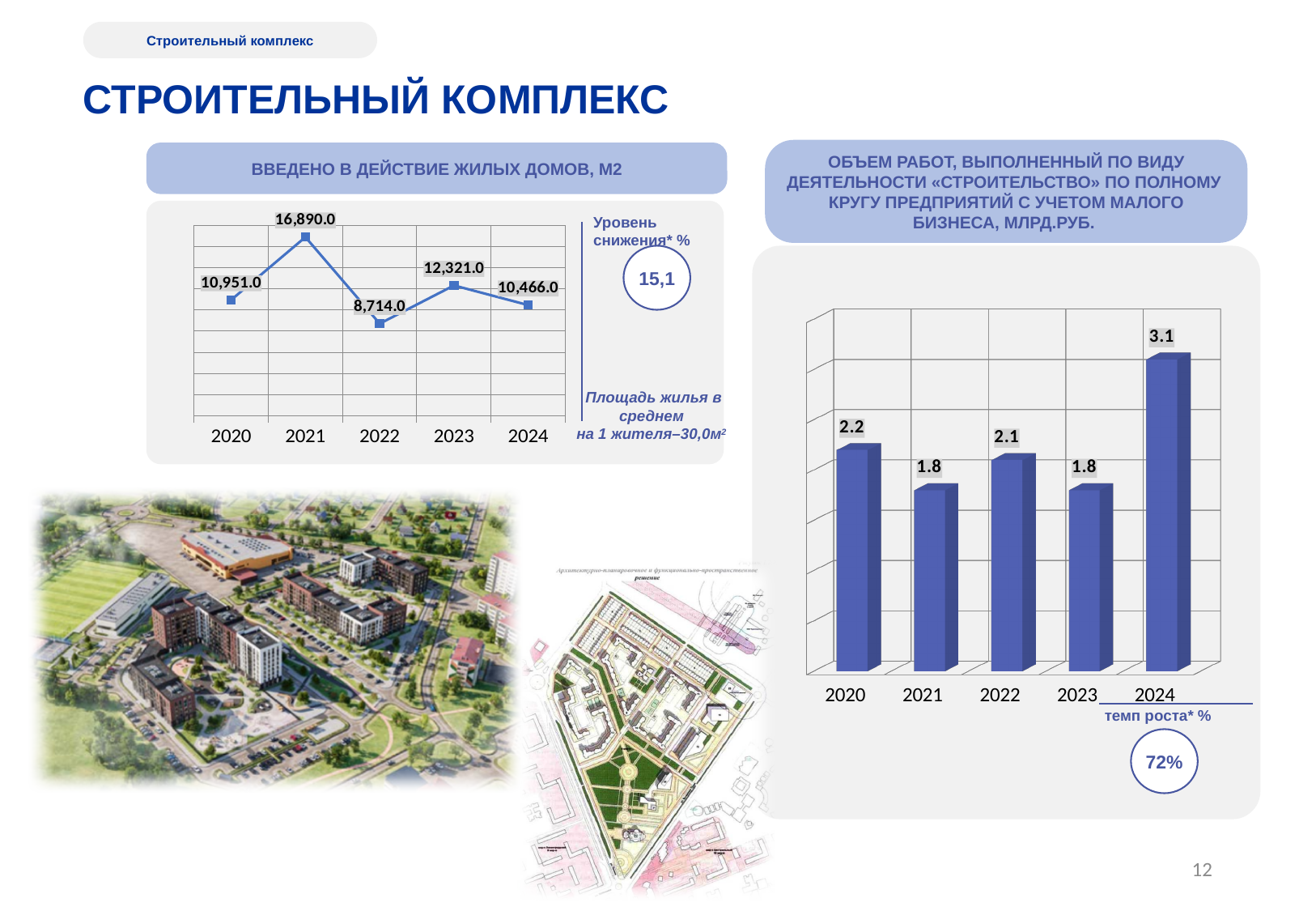
In the left chart (ВВЕДЕНО В ДЕЙСТВИЕ ЖИЛЫХ ДОМОВ, М2), which year has the lowest value? 2022 In the right chart (ОБЪЕМ РАБОТ, МЛРД.РУБ.), which year has the highest value? 2024 In the right chart (ОБЪЕМ РАБОТ, МЛРД.РУБ.), what is the difference between the 2024 and 2023 values? 1.3 In the left chart (ВВЕДЕНО В ДЕЙСТВИЕ ЖИЛЫХ ДОМОВ, М2), which year has the highest value? 2021 In the left chart (ВВЕДЕНО В ДЕЙСТВИЕ ЖИЛЫХ ДОМОВ, М2), what is the value for 2024? 10,466.0 In the left chart (ВВЕДЕНО В ДЕЙСТВИЕ ЖИЛЫХ ДОМОВ, М2), what is the difference between the 2021 and 2022 values? 8,176.0 In the left chart (ВВЕДЕНО В ДЕЙСТВИЕ ЖИЛЫХ ДОМОВ, М2), how many years are plotted? 5 What type of chart is the right chart (ОБЪЕМ РАБОТ, МЛРД.РУБ.)? Bar chart In the left chart (ВВЕДЕНО В ДЕЙСТВИЕ ЖИЛЫХ ДОМОВ, М2), what is the value for 2021? 16,890.0 In the right chart (ОБЪЕМ РАБОТ, МЛРД.РУБ.), what is the value for 2020? 2.2 In the right chart (ОБЪЕМ РАБОТ, МЛРД.РУБ.), what is the value for 2024? 3.1 What type of chart is the left chart (ВВЕДЕНО В ДЕЙСТВИЕ ЖИЛЫХ ДОМОВ, М2)? Line chart